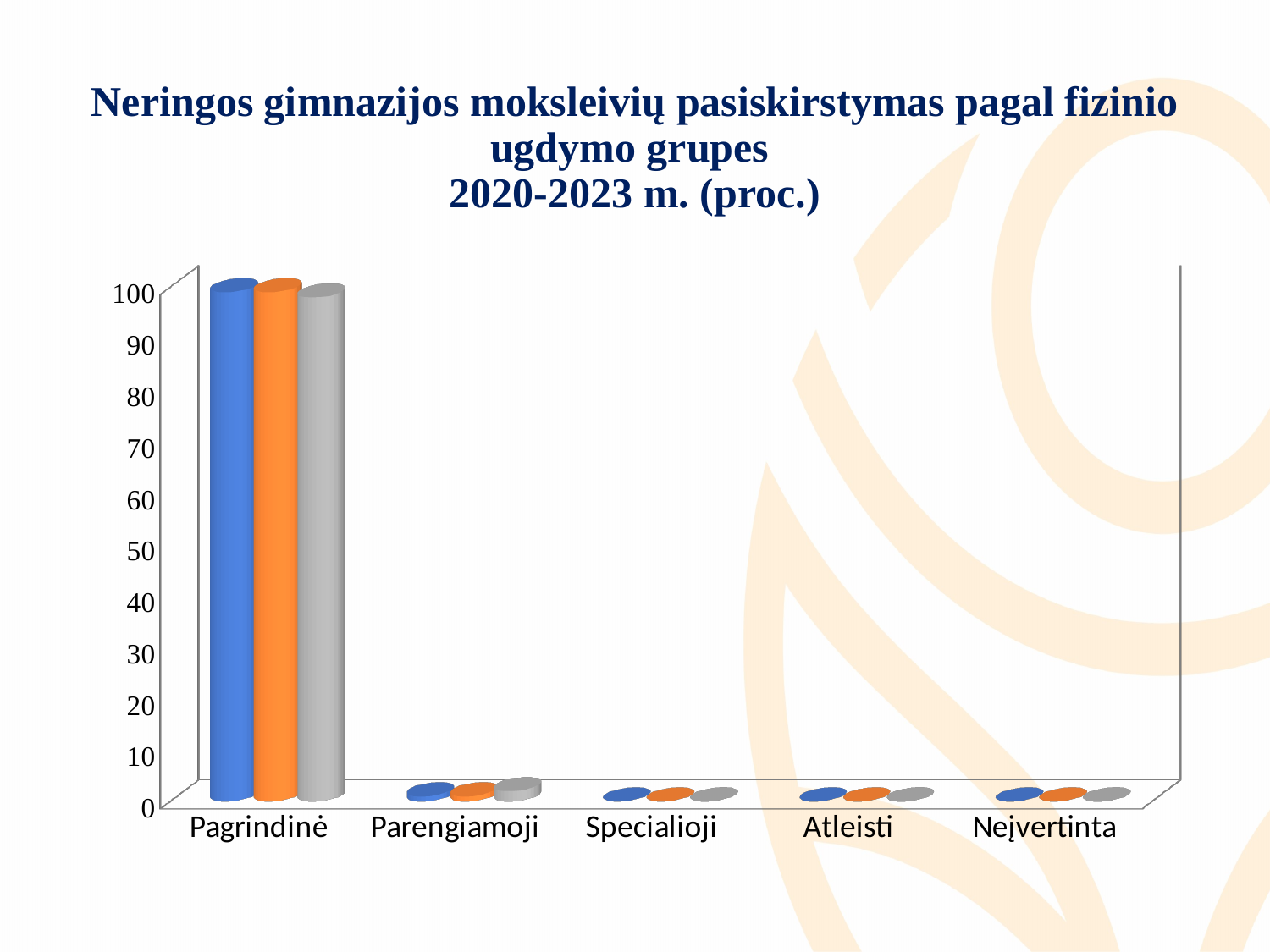
How many categories are shown on the x axis of the chart? 5 How many bars are plotted for each category in the chart? 3 Is the value of the orange bar for Parengiamoji greater or less than 10? less Is the value of the blue bar for Specialioji greater or less than 10? less Which category has larger values, Pagrindinė or Atleisti? Pagrindinė Which category has larger values, Neįvertinta or Pagrindinė? Pagrindinė Is the value of the blue bar for Pagrindinė greater or less than 90? greater Which category has the highest values in the chart? Pagrindinė What is the highest tick value shown on the vertical axis of the chart? 100 What kind of chart is shown on the slide? bar chart What years does the chart title say the data covers? 2020-2023 m.